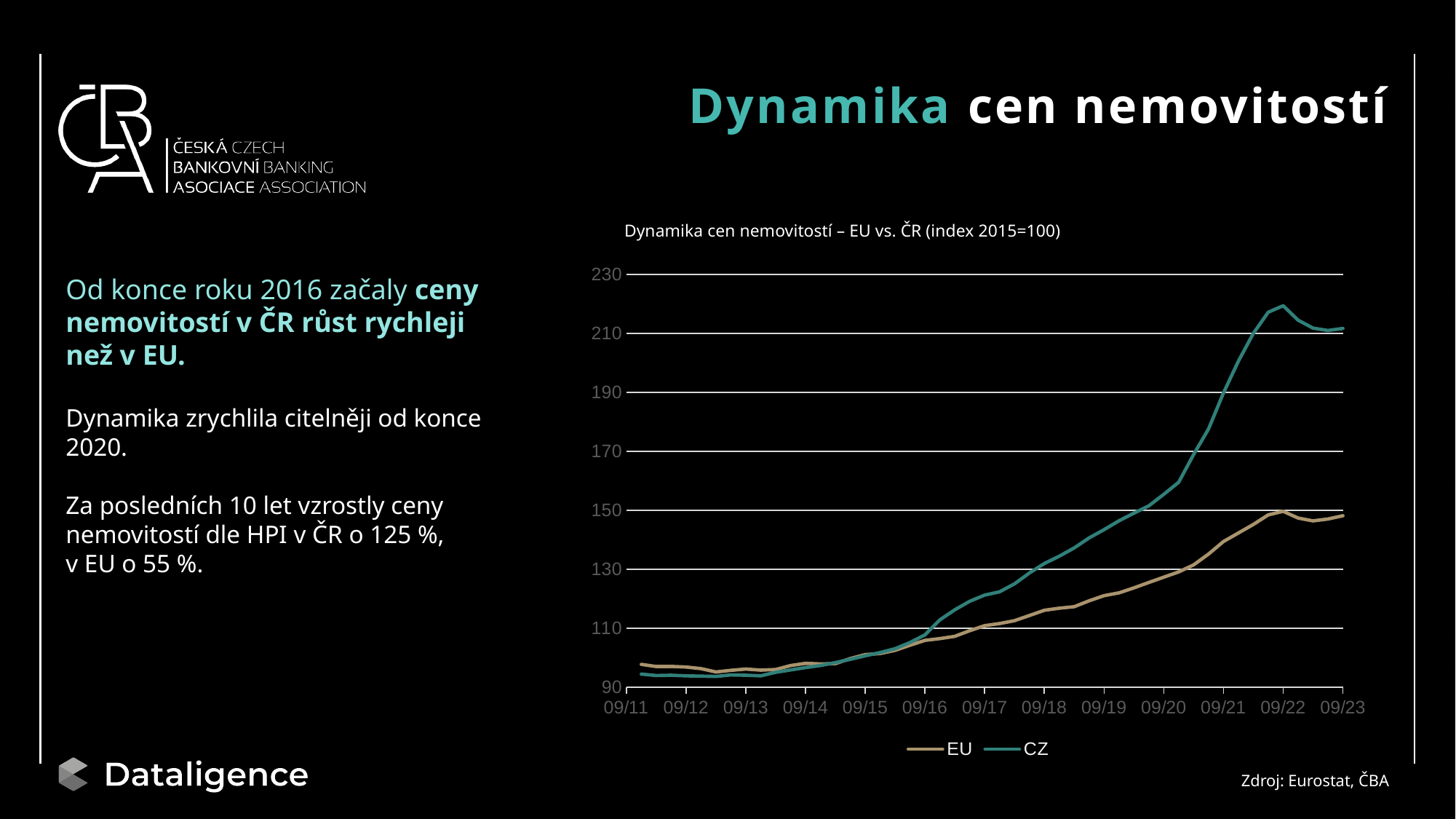
What are the two series named in the chart legend? EU and CZ Is the value of the CZ series at 09/20 greater or less than 150? greater How many series does the chart legend list? 2 What is the title of the chart? Dynamika cen nemovitostí – EU vs. ČR (index 2015=100) Does the CZ series generally rise or fall from 09/11 to 09/23? rise How many date labels are shown on the x axis of the chart? 13 Is the value of the CZ series at 09/21 greater or less than 170? greater Is the value of the CZ series at 09/22 greater or less than 210? greater What kind of chart is shown on the slide? line chart At 09/22, which series has the higher value, EU or CZ? CZ